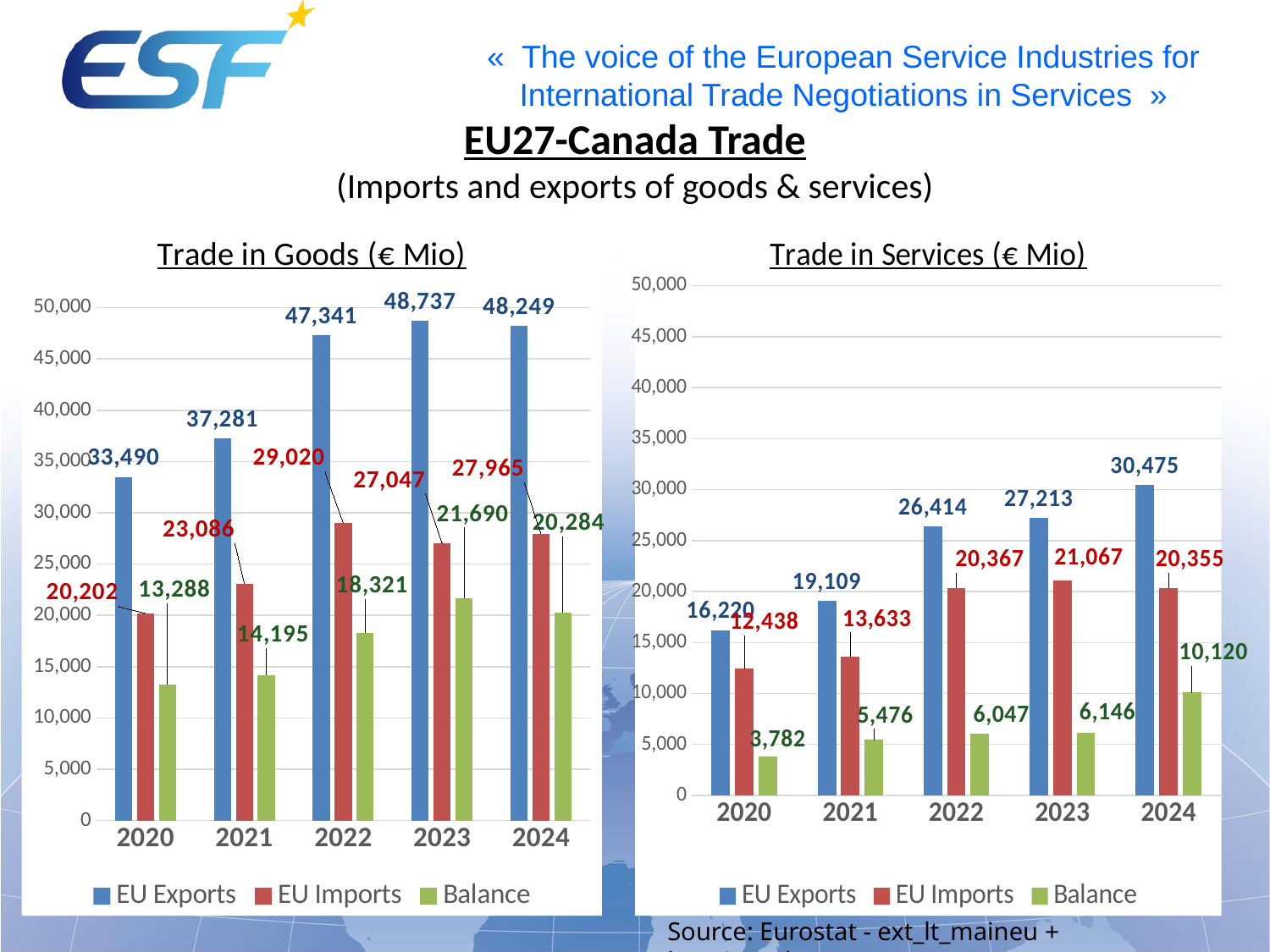
How many series does the legend of the Trade in Goods chart list? 3 In the Trade in Services chart, is the value of EU Exports in 2024 greater or less than 30,000? greater In the Trade in Services chart, what is the value of EU Imports in 2023? 21,067 In the Trade in Services chart, do EU Exports rise or fall from 2020 to 2024? rise In the Trade in Goods chart, what is the Balance for 2021? 14,195 In the Trade in Goods chart, which is larger: EU Imports in 2024 or EU Imports in 2023? EU Imports in 2024 In the Trade in Services chart, what is the difference between EU Exports and EU Imports in 2024? 10,120 In the Trade in Services chart, which year has the lowest Balance? 2020 In the Trade in Goods chart, what is the value of EU Exports in 2022? 47,341 In the Trade in Goods chart, which year has the highest EU Exports value? 2023 How many years are shown on the x axis of the Trade in Services chart? 5 In the Trade in Goods chart, what is the difference between EU Imports in 2022 and EU Imports in 2021? 5,934